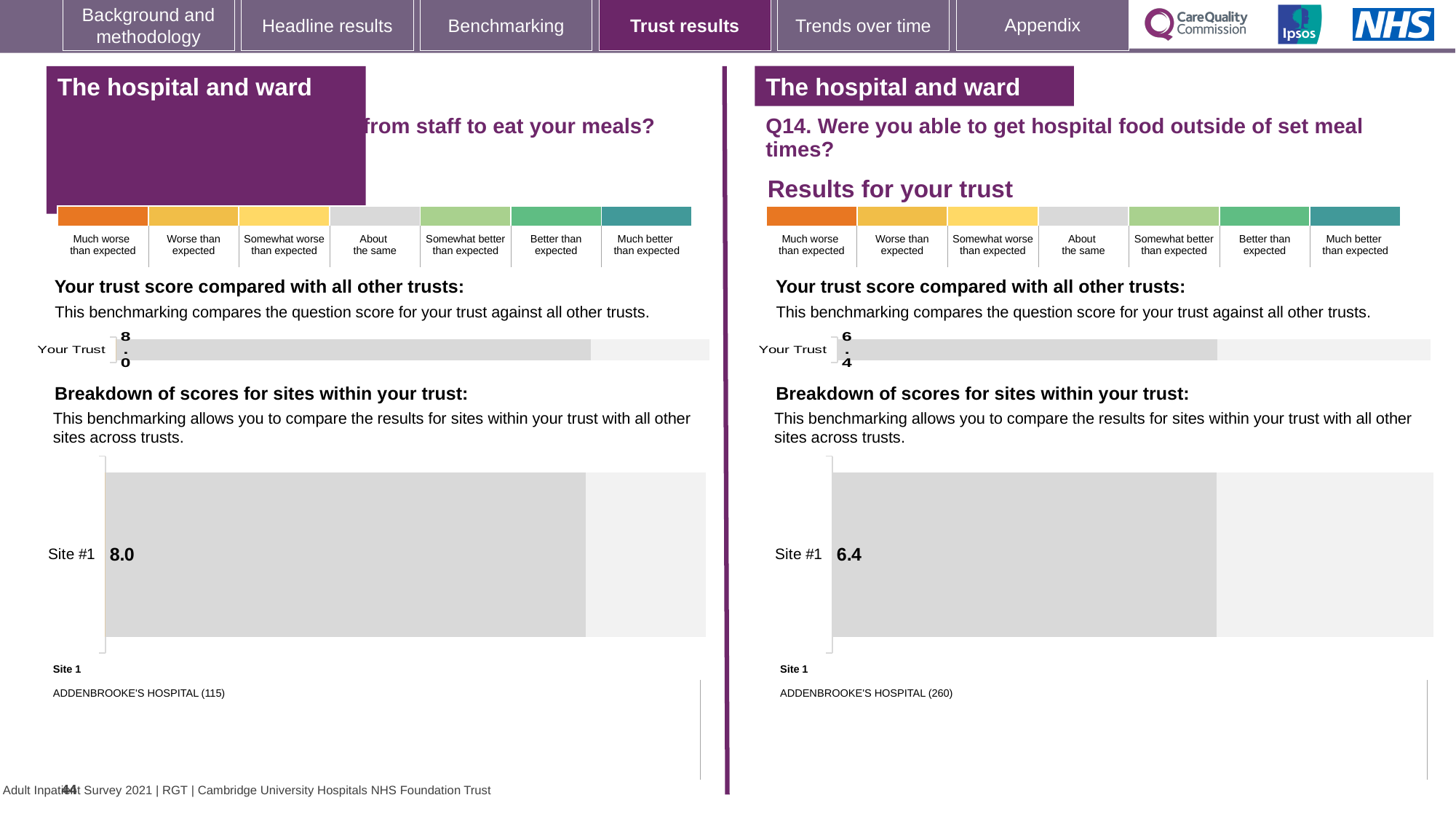
On the right-hand side of the slide (Q14), what is the value shown for Your Trust in the 'Your trust score compared with all other trusts' chart? 6.4 Which hospital is listed as Site 1 beneath the right-hand breakdown chart (Q14), and what number is shown in brackets? ADDENBROOKE'S HOSPITAL (260) What is the difference between the Site #1 score on the left-hand side of the slide (8.0) and the Site #1 score on the right-hand side (6.4)? 1.6 How many sites are shown in the left-hand 'Breakdown of scores for sites within your trust' chart? 1 In the right-hand 'Breakdown of scores for sites within your trust' chart (Q14), what is the value for Site #1? 6.4 What type of chart is used to show the Site #1 score on the right-hand side of the slide? Bar chart What number is shown in brackets after ADDENBROOKE'S HOSPITAL beneath the left-hand breakdown chart? 115 In the left-hand 'Breakdown of scores for sites within your trust' chart, what is the value for Site #1? 8.0 How many sites are shown in the right-hand 'Breakdown of scores for sites within your trust' chart? 1 On the left-hand side of the slide, what is the value shown for Your Trust in the 'Your trust score compared with all other trusts' chart? 8.0 Which is larger: the Your Trust score on the left-hand side of the slide or the Your Trust score on the right-hand side (Q14)? Left-hand side (8.0)